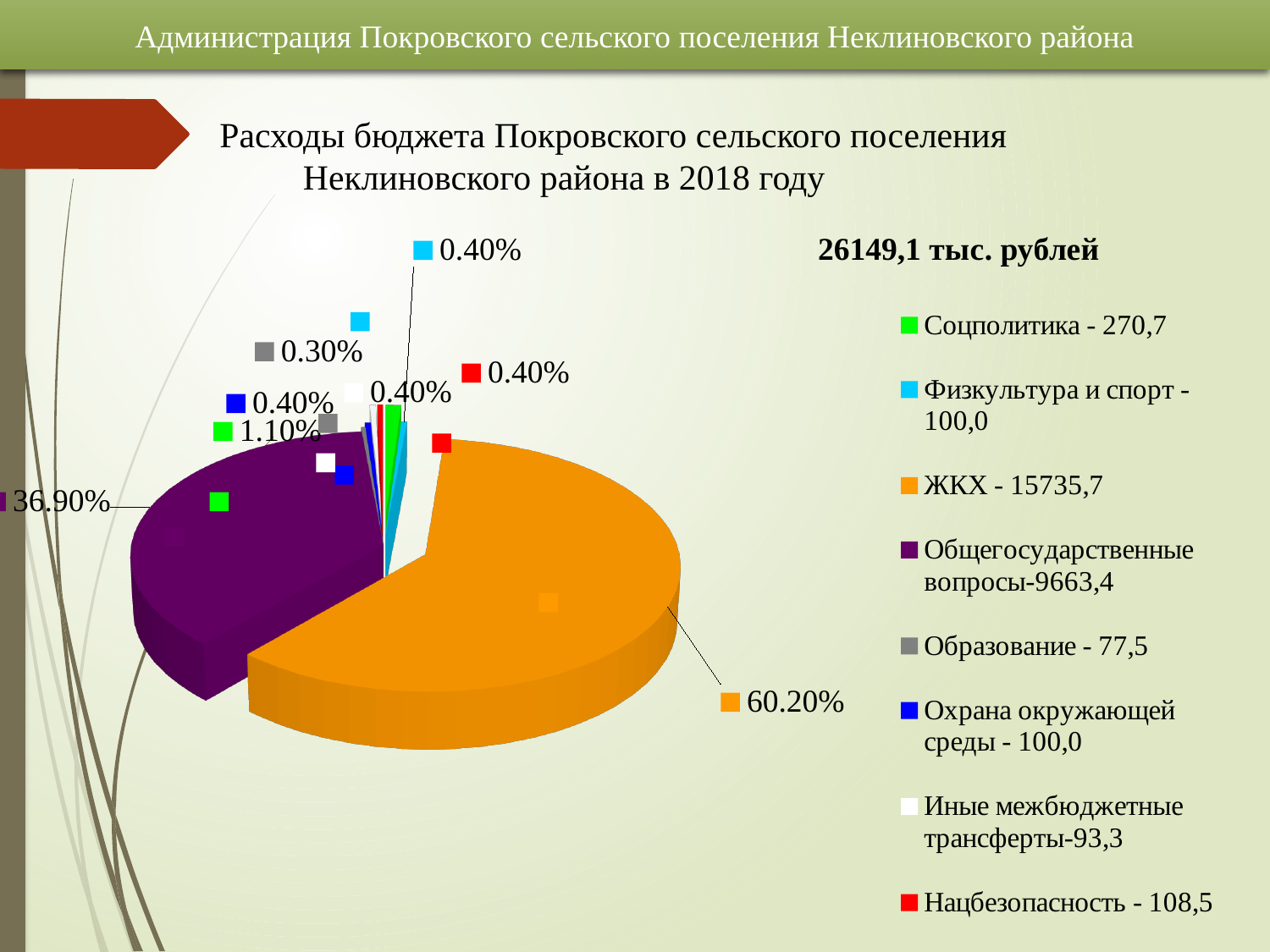
Which category has the smallest slice of the pie? Образование What value does the legend give for ЖКХ? 15735,7 What is the difference in percentage points between the ЖКХ share and the Общегосударственные вопросы share? 23.30% What kind of chart is shown on the slide? Pie chart What percentage share of the pie does Общегосударственные вопросы have? 36.90% What percentage share of the pie does Соцполитика have? 1.10% What percentage share of the pie does ЖКХ have? 60.20% Which category has the largest slice of the pie? ЖКХ Which is larger, the share for ЖКХ or the share for Общегосударственные вопросы? ЖКХ What value does the legend give for Нацбезопасность? 108,5 How many categories does the legend list? 8